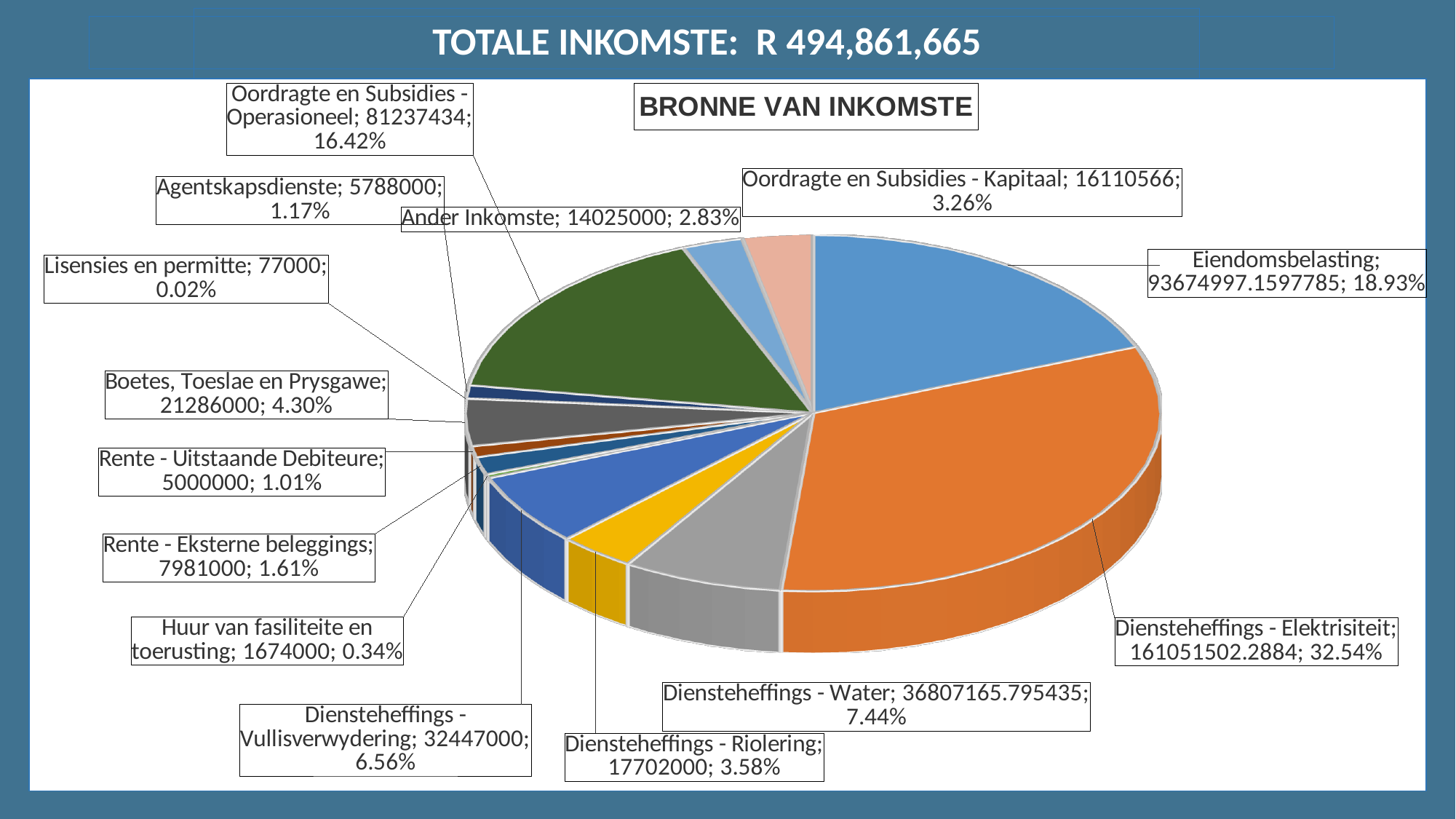
Which category has the largest share of the pie? Diensteheffings - Elektrisiteit What kind of chart is shown on the slide? pie chart What is the title of the chart? BRONNE VAN INKOMSTE What is the value for Boetes, Toeslae en Prysgawe? 21286000 Which is larger: Diensteheffings - Water or Diensteheffings - Vullisverwydering? Diensteheffings - Water How many categories (slices) does the pie chart have? 14 What is the difference in value between Diensteheffings - Riolering and Oordragte en Subsidies - Kapitaal? 1591434 What is the value for Oordragte en Subsidies - Operasioneel? 81237434 Which category has the smallest share of the pie? Lisensies en permitte What is the value for Rente - Eksterne beleggings? 7981000 What percentage share does Diensteheffings - Elektrisiteit have? 32.54% What percentage share does Eiendomsbelasting have? 18.93%